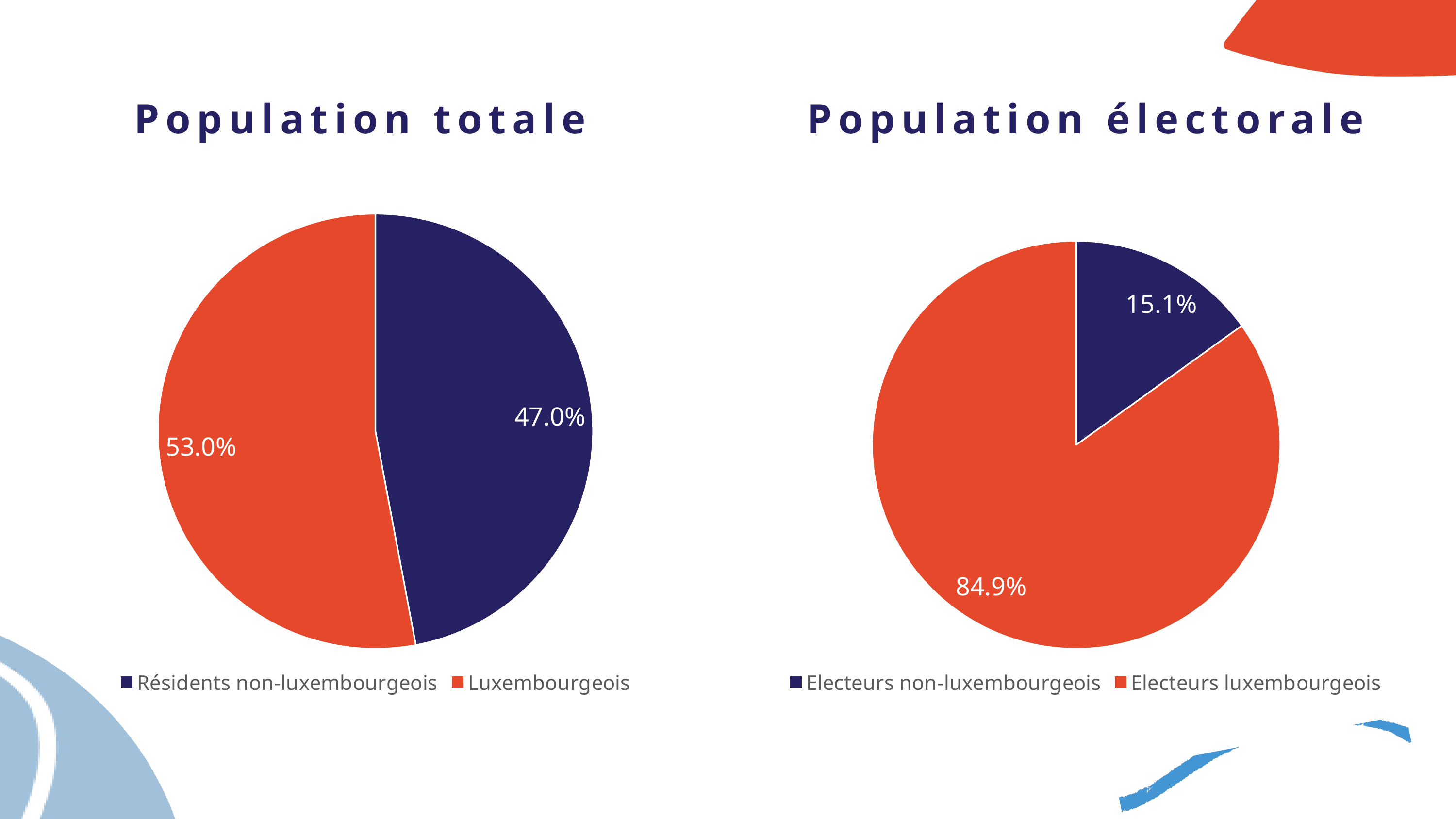
Which is larger: the non-Luxembourgish share in the 'Population totale' chart or in the 'Population électorale' chart? Population totale In the 'Population électorale' chart, what is the difference between the Electeurs luxembourgeois and Electeurs non-luxembourgeois shares? 69.8% How many slices does the 'Population totale' chart have? 2 In the 'Population totale' chart, what share is labelled for Résidents non-luxembourgeois? 47.0% In the 'Population totale' chart, which slice is the largest? Luxembourgeois In the 'Population électorale' chart, which slice is the smallest? Electeurs non-luxembourgeois In the 'Population totale' chart, what is the difference between the Luxembourgeois and Résidents non-luxembourgeois shares? 6.0% In the 'Population électorale' chart, what share is labelled for Electeurs luxembourgeois? 84.9% In the 'Population électorale' chart, what colour is the Electeurs luxembourgeois slice? Orange-red In the 'Population électorale' chart, what share is labelled for Electeurs non-luxembourgeois? 15.1% In the 'Population totale' chart, what share is labelled for Luxembourgeois? 53.0% What kind of chart is the 'Population électorale' chart? Pie chart